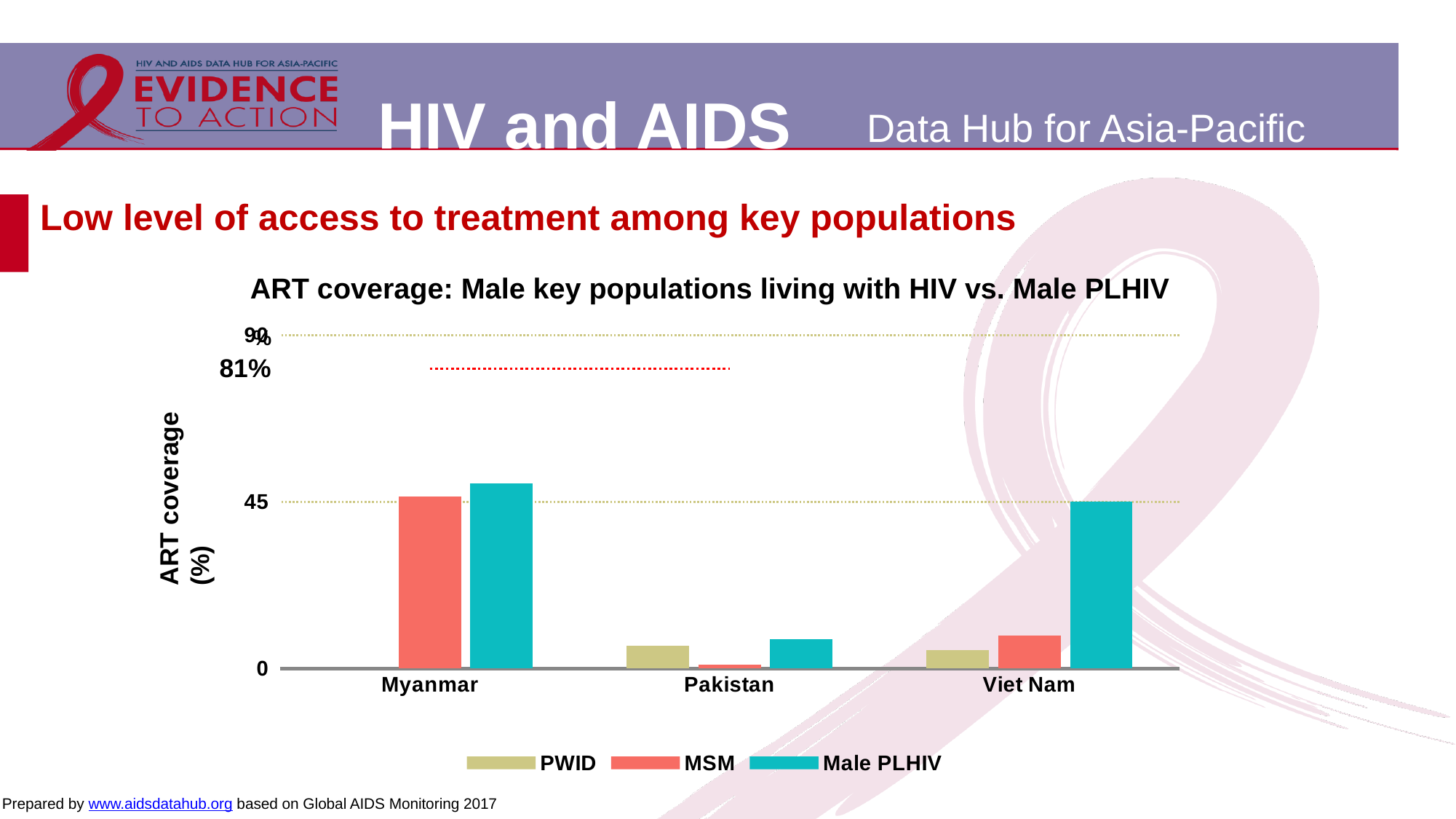
How many series does the chart's legend list? 3 Which country has the lowest MSM bar? Pakistan Is the Male PLHIV value for Myanmar greater or less than 45? greater In Viet Nam, which is larger: the PWID value or the Male PLHIV value? Male PLHIV Is the Male PLHIV value for Pakistan greater or less than 45? less What kind of chart is shown on the slide? bar chart Is the MSM value for Viet Nam greater or less than 45? less How many countries are shown on the x axis of the chart? 3 What is the title of the chart? ART coverage: Male key populations living with HIV vs. Male PLHIV In Pakistan, which is larger: the MSM value or the Male PLHIV value? Male PLHIV What are the three series listed in the chart's legend? PWID, MSM, Male PLHIV Which country has the highest Male PLHIV bar? Myanmar